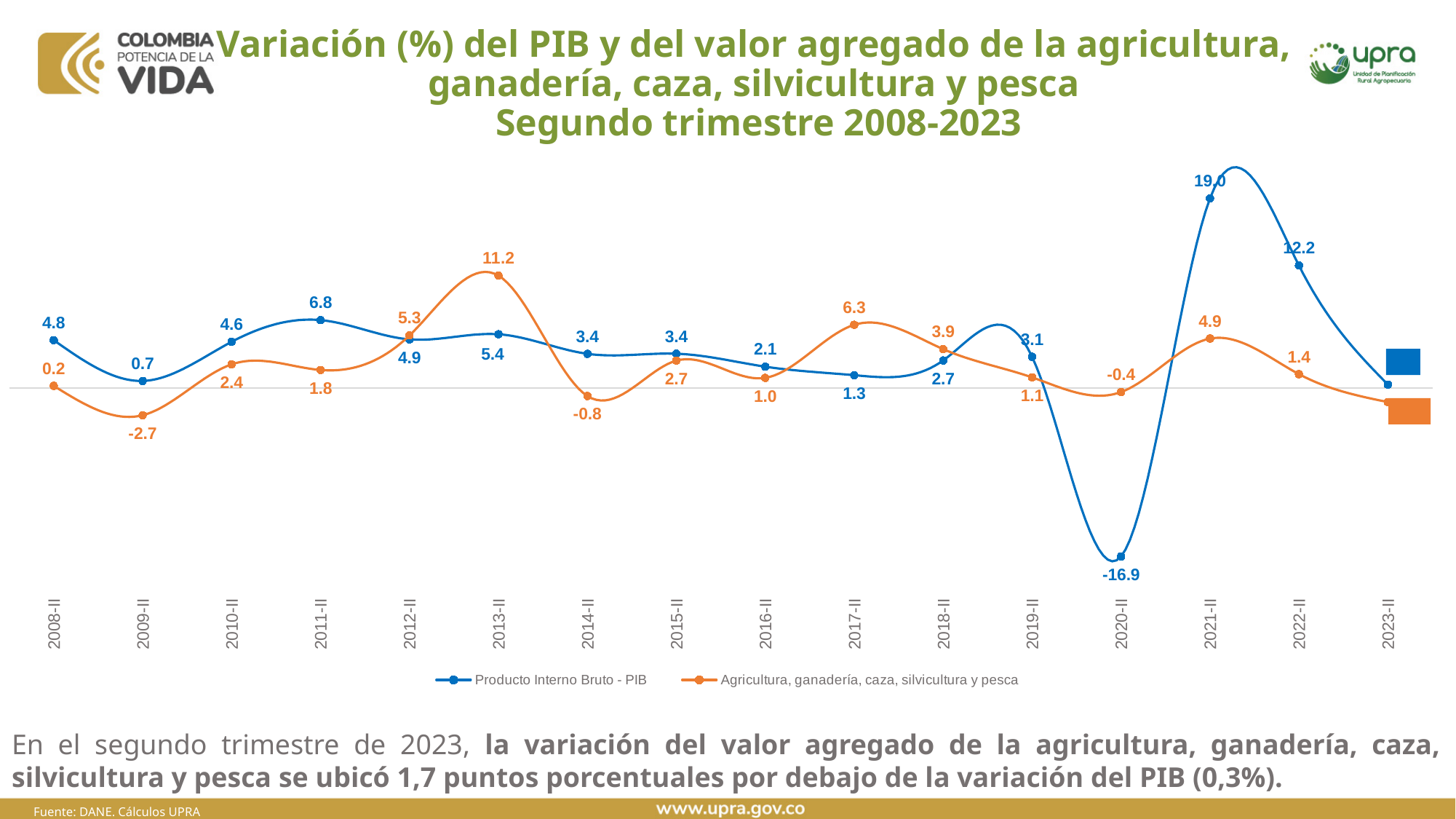
In 2017-II, which series has the higher value: Producto Interno Bruto - PIB or Agricultura, ganadería, caza, silvicultura y pesca? Agricultura, ganadería, caza, silvicultura y pesca In which period does the Producto Interno Bruto - PIB series reach its highest value? 2021-II How many series does the legend list? 2 What is the difference between the PIB value and the Agricultura value in 2021-II? 14.1 What is the value of Agricultura, ganadería, caza, silvicultura y pesca for 2013-II? 11.2 What kind of chart is shown on the slide? Line chart What is the value of Producto Interno Bruto - PIB for 2020-II? -16.9 In which period does the Producto Interno Bruto - PIB series reach its lowest value? 2020-II How many periods are shown on the x axis of the chart? 16 In which period does the Agricultura, ganadería, caza, silvicultura y pesca series reach its lowest value? 2009-II What is the value of Producto Interno Bruto - PIB for 2011-II? 6.8 In which period does the Agricultura, ganadería, caza, silvicultura y pesca series reach its highest value? 2013-II